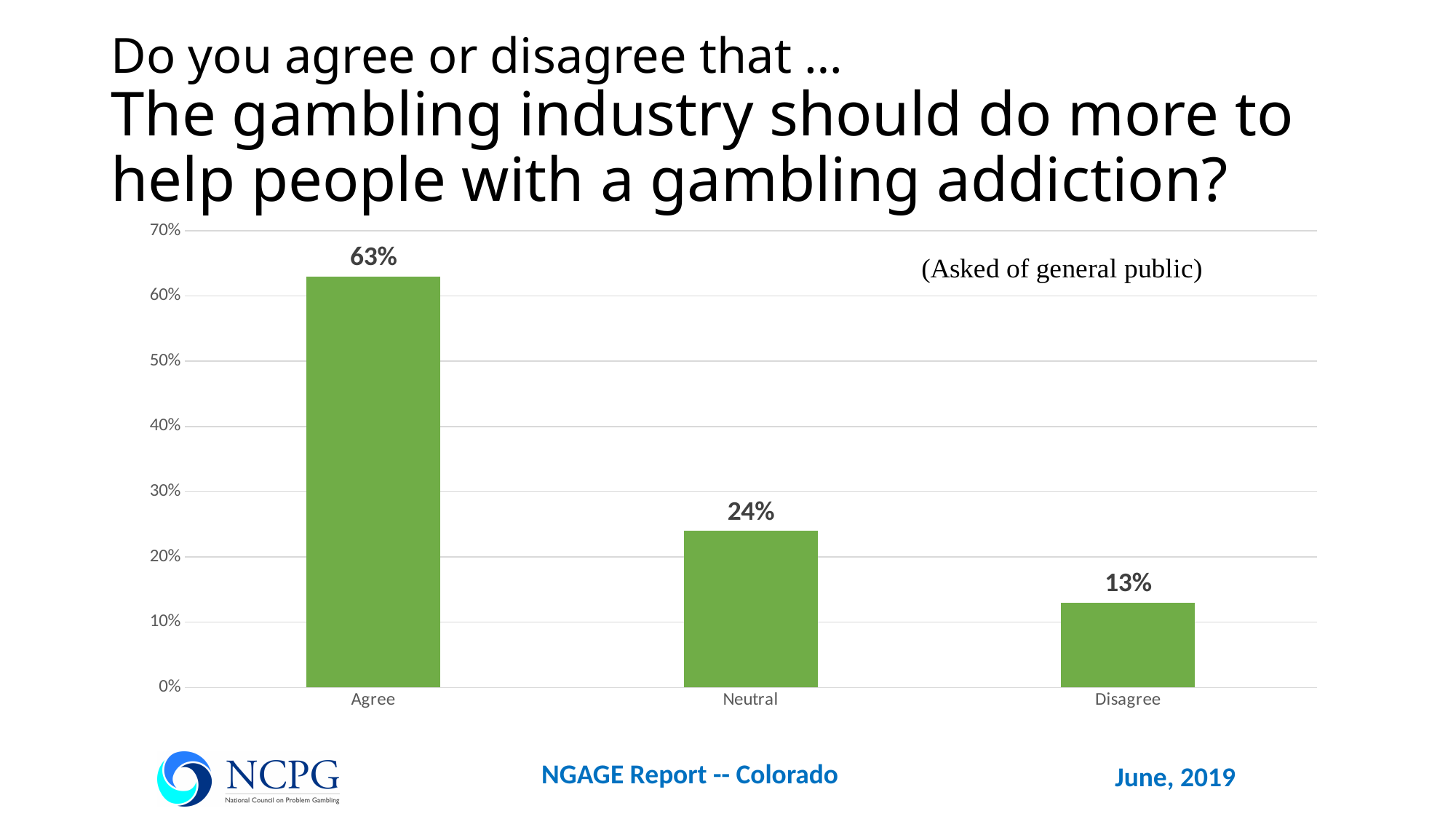
How many response categories are shown on the chart? 3 What percentage of respondents chose Neutral? 24% What is the difference in percentage points between Neutral and Disagree? 11 What kind of chart is shown on the slide? Bar chart Which is larger, the value for Neutral or the value for Disagree? Neutral Is the value for Agree greater or less than 60%? greater What percentage of respondents chose Agree? 63% What is the difference in percentage points between Agree and Disagree? 50 Which response category has the lowest value? Disagree Which response category has the highest value? Agree What percentage of respondents chose Disagree? 13% Do the values rise or fall from left to right across the categories? Fall